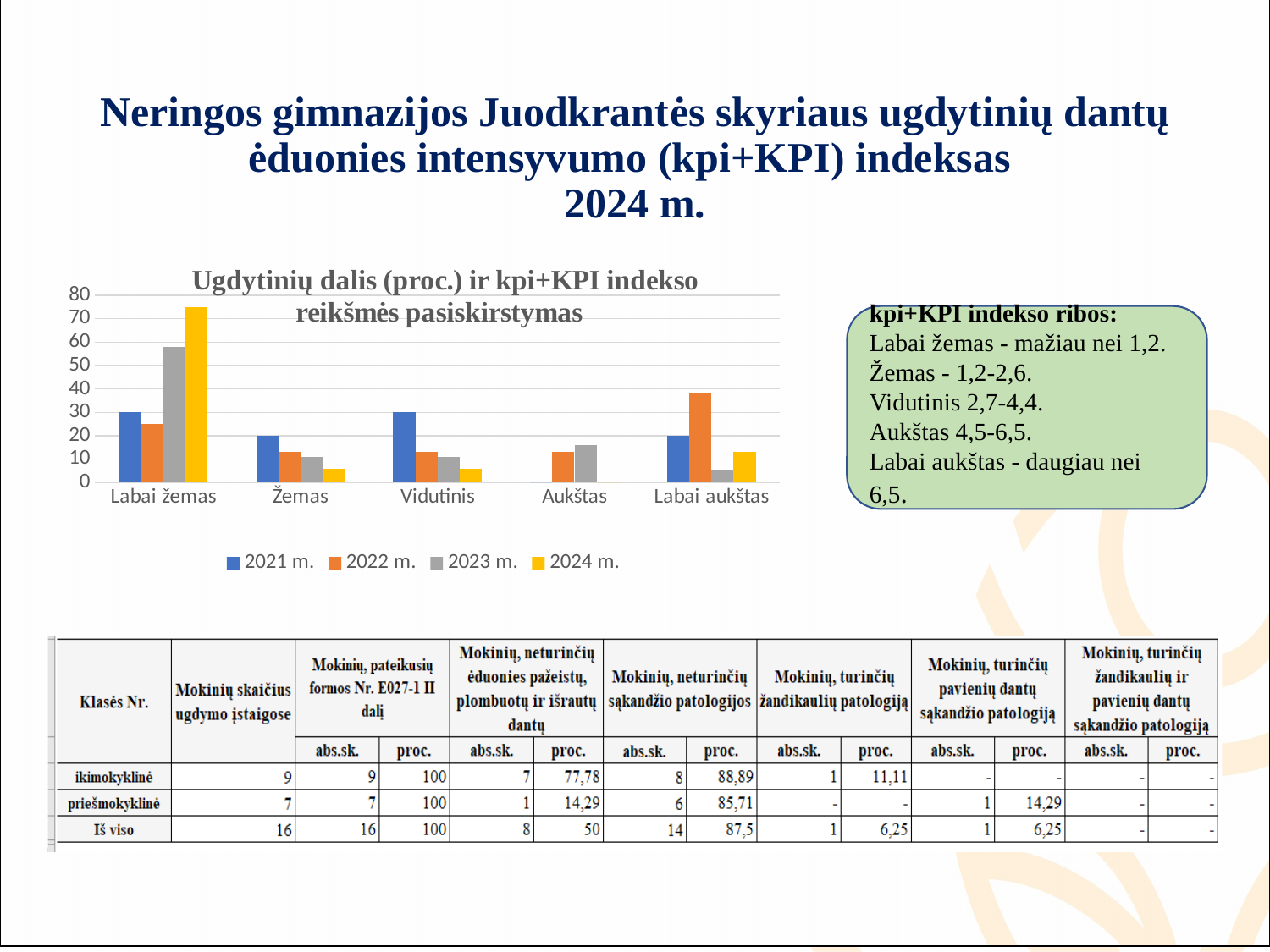
Which category has the highest value for the 2022 m. series? Labai aukštas Is the value for 2023 m. in the Labai žemas category greater or less than 50? greater Is the value for 2024 m. in the Žemas category greater or less than 10? less What kind of chart is shown on the slide? bar chart How many categories are shown along the x axis of the chart? 5 Is the value for 2024 m. in the Labai žemas category greater or less than 70? greater Which series is shown in yellow in the chart legend? 2024 m. Which is larger in the Vidutinis category: the value for 2021 m. or the value for 2024 m.? 2021 m. Which category has the highest value for the 2024 m. series? Labai žemas Which category has the highest value for the 2023 m. series? Labai žemas Which is larger in the Labai aukštas category: the value for 2022 m. or the value for 2023 m.? 2022 m. How many series does the chart legend list? 4